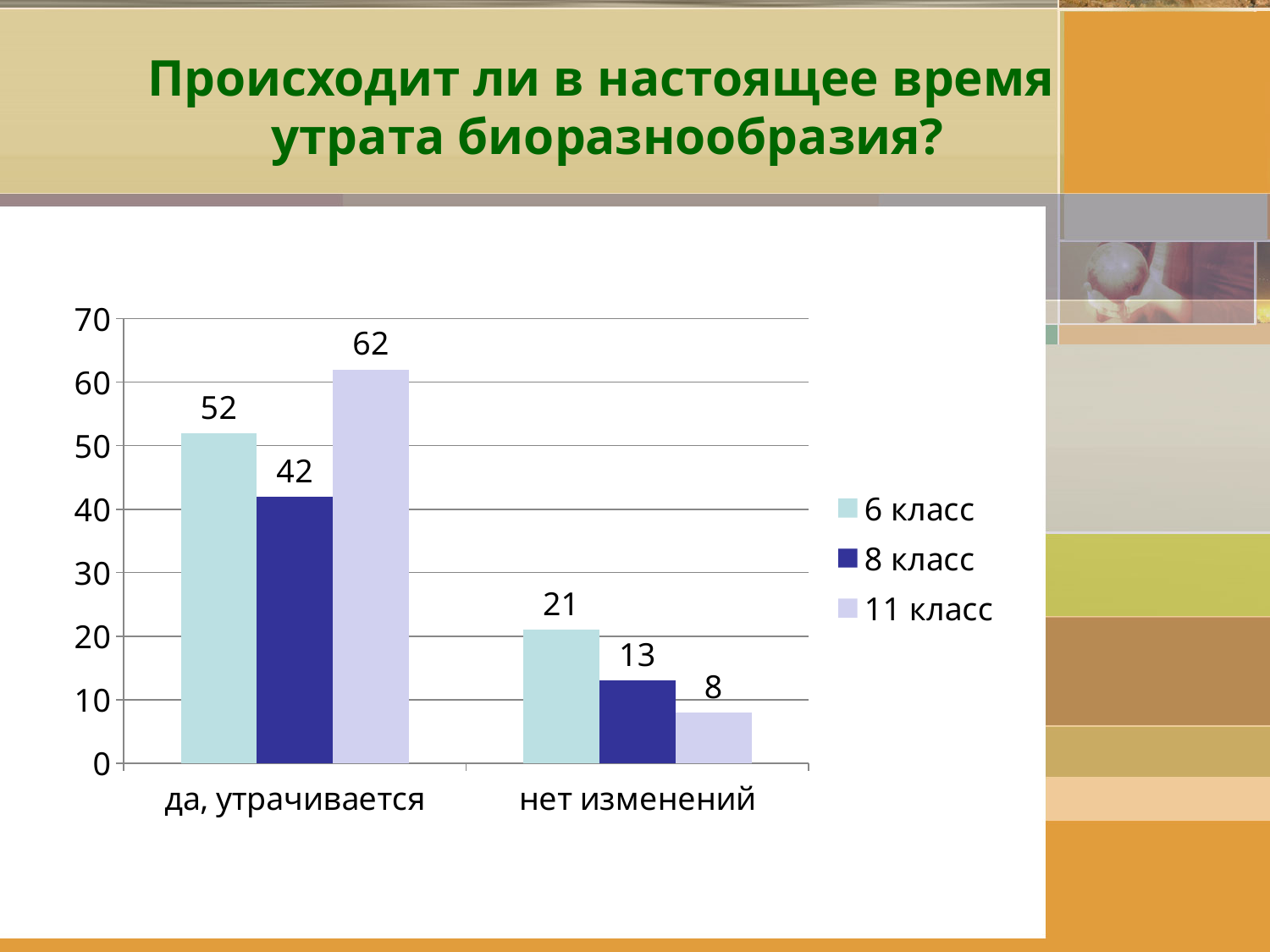
What is the value for 6 класс in the category "да, утрачивается"? 52 What is the value for 11 класс in the category "да, утрачивается"? 62 How many series does the legend list? 3 Which is larger: the 6 класс value for "нет изменений" or the 8 класс value for "нет изменений"? 6 класс How many categories are shown on the x axis? 2 What is the value for 8 класс in the category "нет изменений"? 13 What kind of chart is shown on the slide? bar chart What is the difference between the 6 класс values for "да, утрачивается" and "нет изменений"? 31 What is the title of the slide above the chart? Происходит ли в настоящее время утрата биоразнообразия? Which series has the highest value in the category "да, утрачивается"? 11 класс What is the difference between the 11 класс and 8 класс values in the category "да, утрачивается"? 20 Which series has the lowest value in the category "нет изменений"? 11 класс